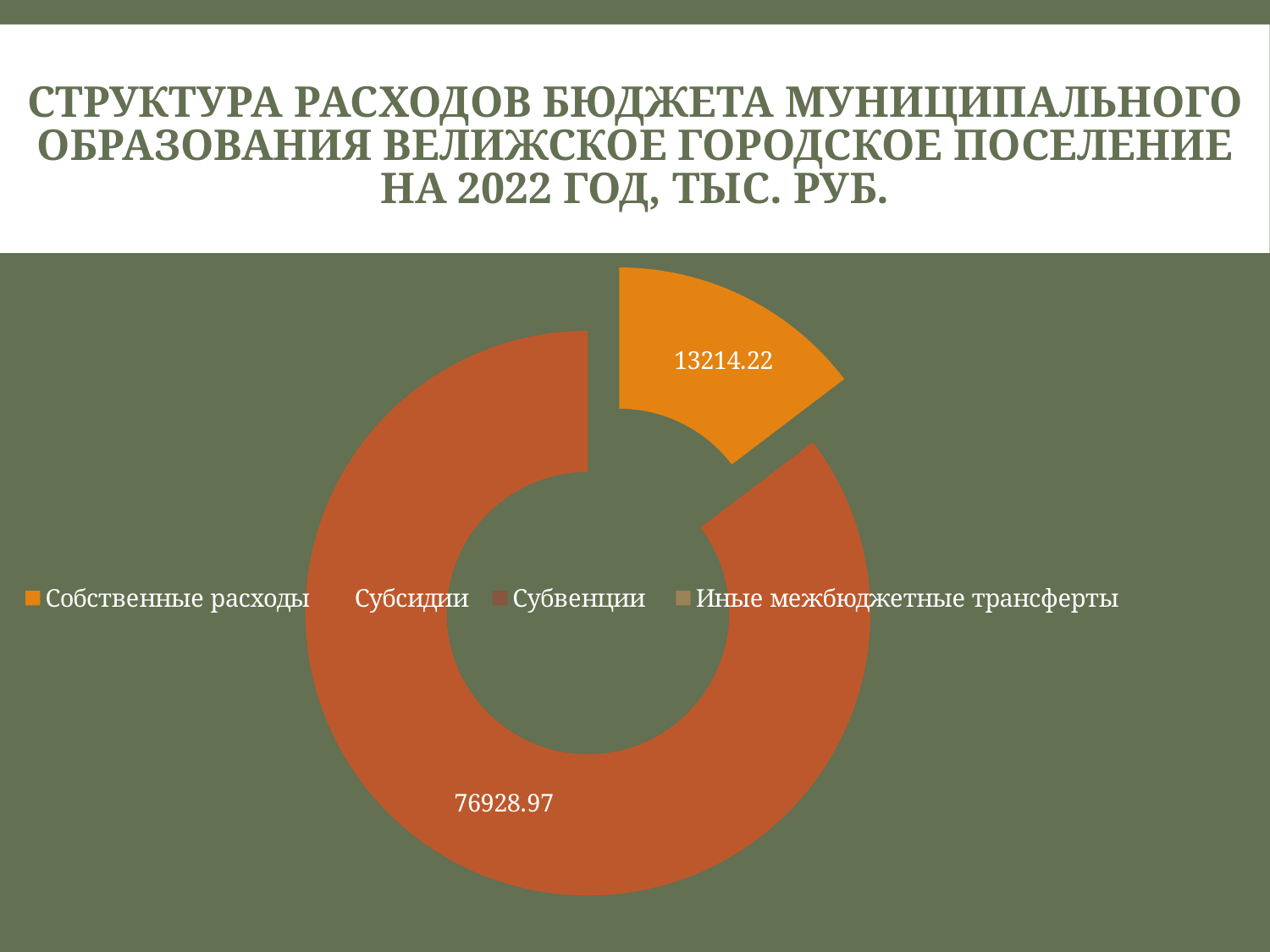
Which year does the chart title refer to? 2022 What value is printed on the large red-brown slice of the chart? 76928.97 In what units are the values given, according to the title? тыс. руб. Which is larger: the orange slice (Собственные расходы) or the red-brown slice? The red-brown slice (76928.97) What value is shown for Собственные расходы (the orange slice)? 13214.22 What colour is the legend marker for Собственные расходы? Orange How many entries does the chart legend list? 4 What is the difference between the two printed values, 76928.97 and 13214.22? 63714.75 How many slices with data labels are visible in the chart? 2 What is the smallest value printed on the chart? 13214.22 What kind of chart is shown on the slide? Doughnut (pie) chart What is the largest value printed on the chart? 76928.97